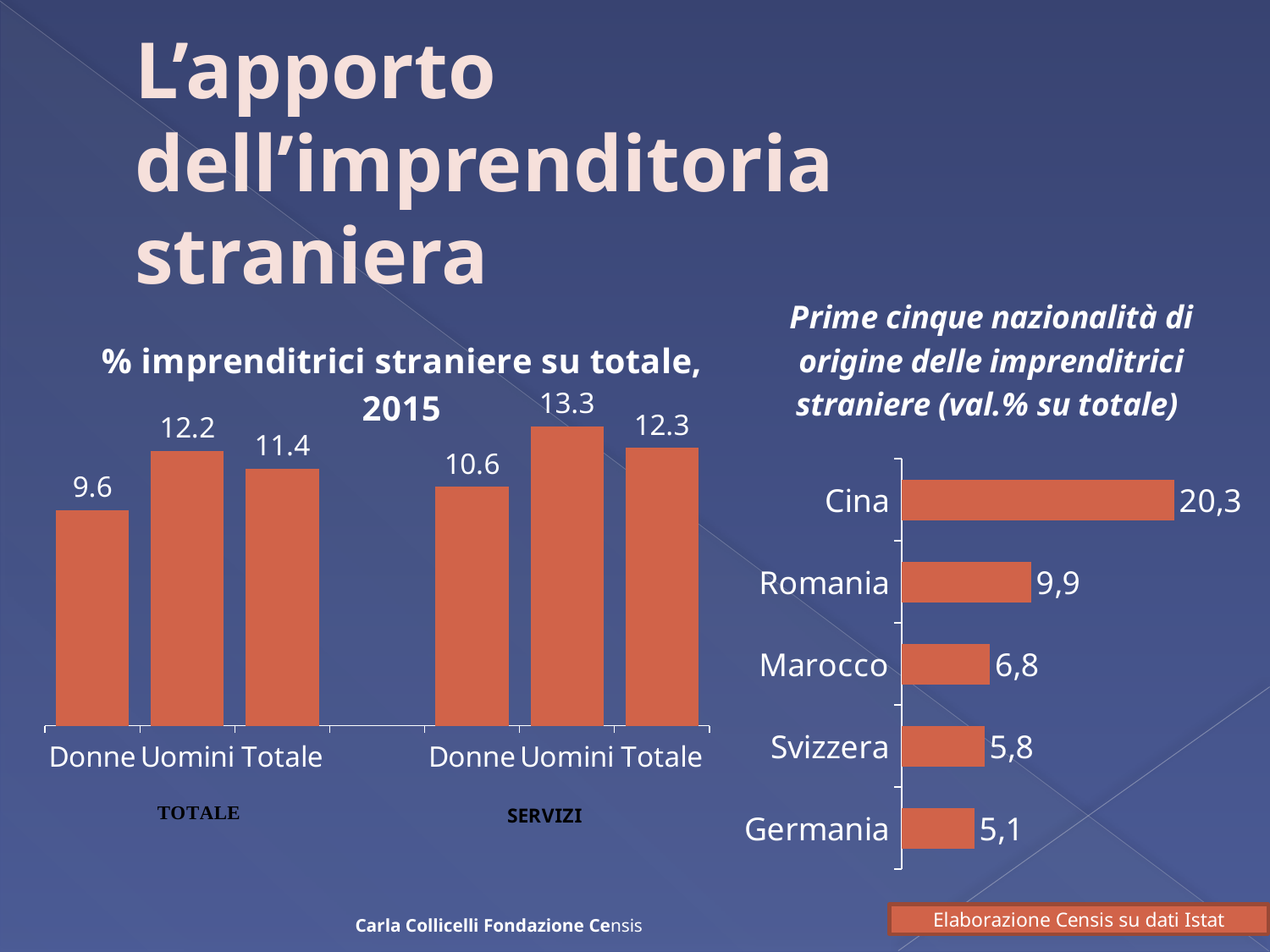
In the chart 'Prime cinque nazionalità di origine delle imprenditrici straniere', what is the difference between Cina and Marocco? 13,5 In the chart 'Prime cinque nazionalità di origine delle imprenditrici straniere', which nationality has the highest value? Cina In the chart 'Prime cinque nazionalità di origine delle imprenditrici straniere', which nationality has the lowest value? Germania What kind of chart is 'Prime cinque nazionalità di origine delle imprenditrici straniere'? Bar chart In the chart '% imprenditrici straniere su totale, 2015', what is the value for Donne in the TOTALE group? 9.6 In the chart 'Prime cinque nazionalità di origine delle imprenditrici straniere', what is the value for Romania? 9,9 In the chart '% imprenditrici straniere su totale, 2015', what is the difference between Uomini and Donne in the TOTALE group? 2.6 In the chart '% imprenditrici straniere su totale, 2015', which bar has the highest value? Uomini (SERVIZI) How many bars are plotted in the chart '% imprenditrici straniere su totale, 2015'? 6 In the chart '% imprenditrici straniere su totale, 2015', which bar has the lowest value? Donne (TOTALE) In the chart '% imprenditrici straniere su totale, 2015', is the Totale value larger in the TOTALE group or in the SERVIZI group? SERVIZI In the chart '% imprenditrici straniere su totale, 2015', what is the value for Uomini in the SERVIZI group? 13.3